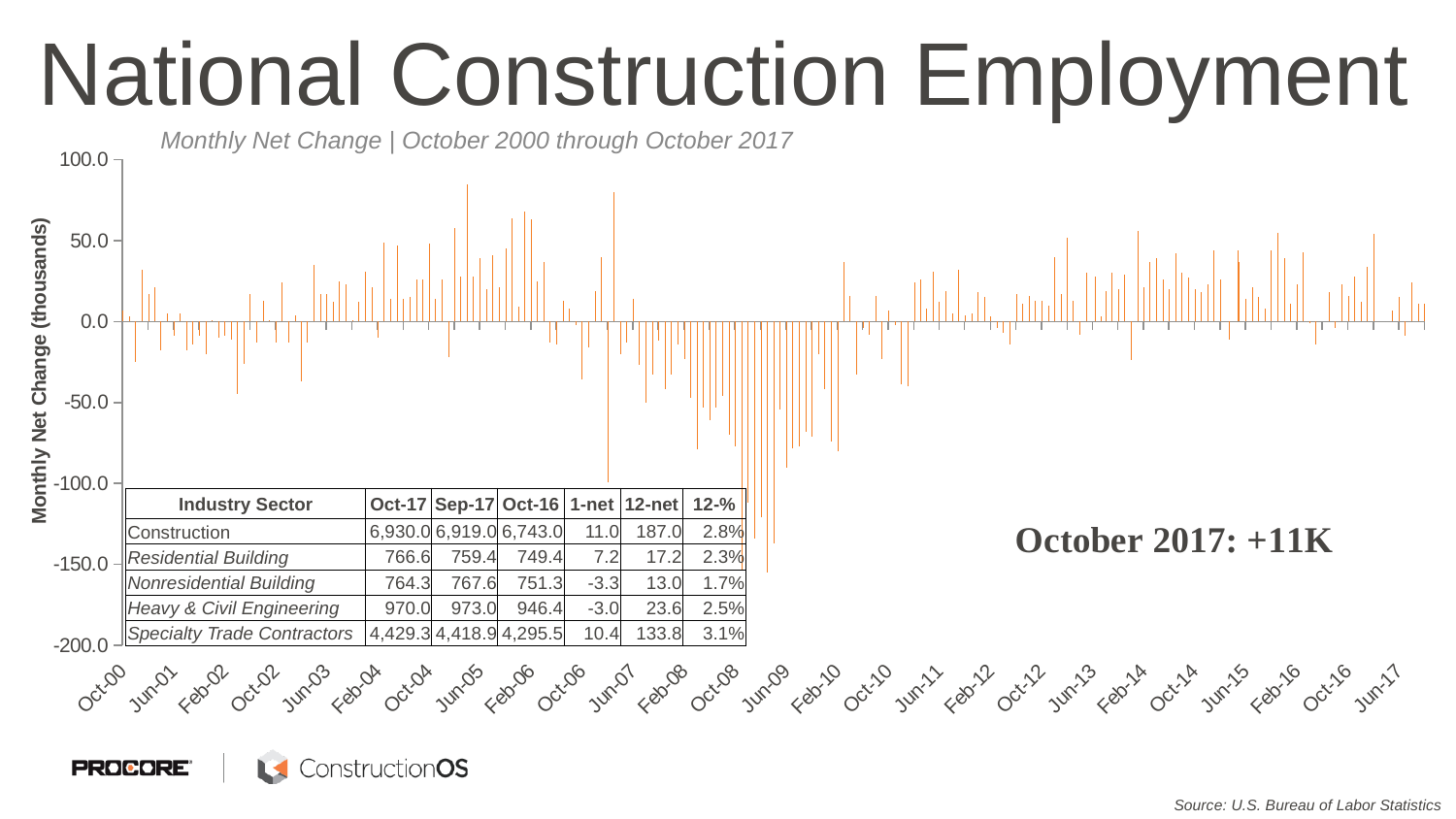
According to the annotation on the chart, what was the net change in October 2017? +11K Are the monthly net change values mostly positive or mostly negative between Feb-08 and Jun-09? Mostly negative What is the title of the chart on the slide? National Construction Employment What is the label on the vertical axis of the chart? Monthly Net Change (thousands) What period does the chart's subtitle say the data covers? October 2000 through October 2017 What kind of chart is shown on the slide? Bar chart Do the monthly net change values generally rise or fall from Oct-07 to Jun-09? Fall In the table on the chart, what is the Oct-17 value for Construction? 6,930.0 Is the lowest bar on the chart, around mid-2009, greater or less than -100? less Is the tallest positive bar on the chart, around mid-2005, greater or less than 50? greater In the table on the chart, what is the 12-% value for Specialty Trade Contractors? 3.1%